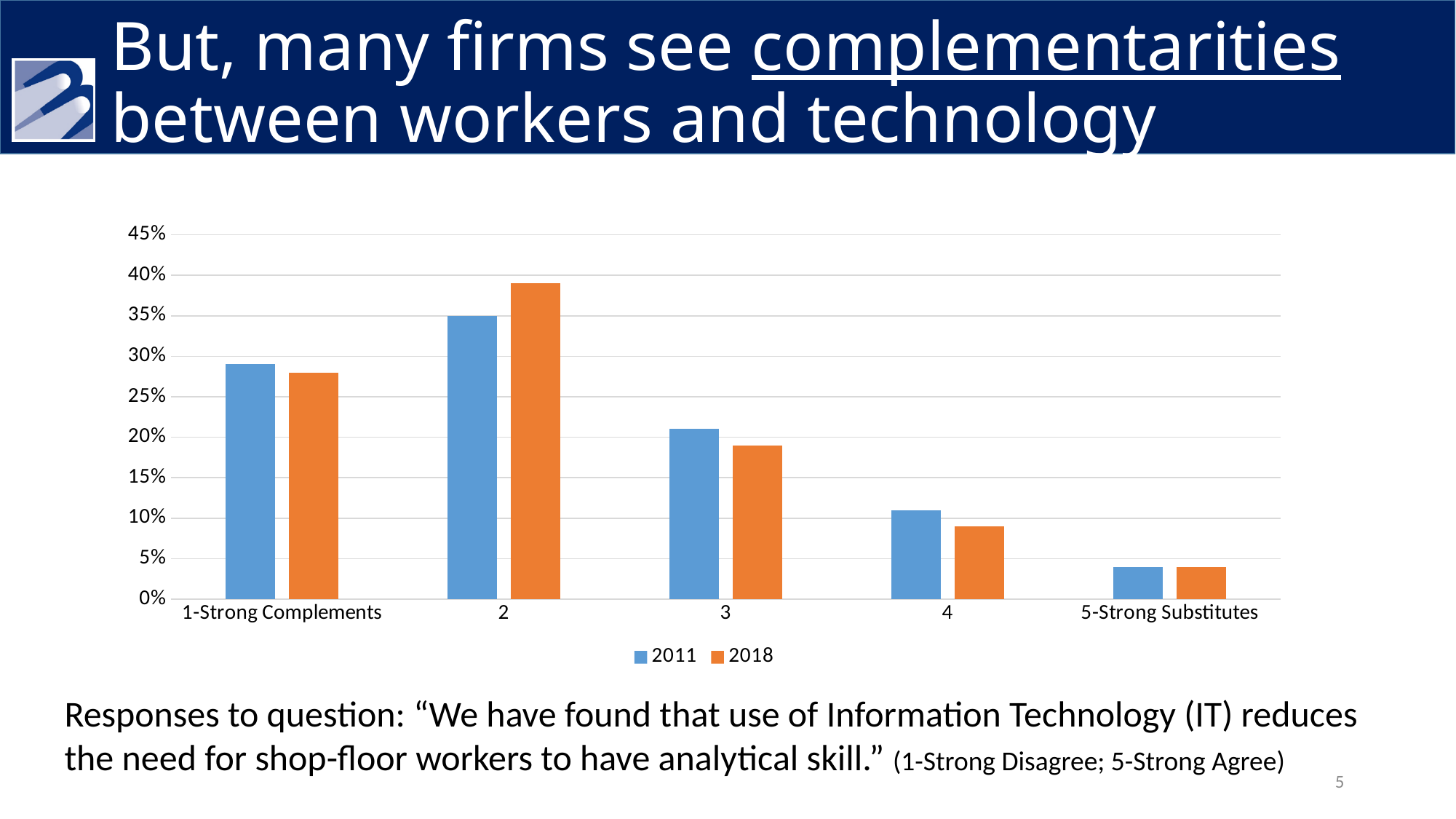
From category 2 to 5-Strong Substitutes, do the 2018 values rise or fall? fall For category 2, which series has the larger value, 2011 or 2018? 2018 Is the 2018 value for category 2 greater or less than 35%? greater What kind of chart is shown on the slide? bar chart Which category has the highest value for the 2011 series? 2 Which category has the highest value for the 2018 series? 2 How many categories are shown on the x axis? 5 For category 3, which series has the larger value, 2011 or 2018? 2011 Is the 2011 value for 1-Strong Complements greater or less than 25%? greater Which category has the lowest value for the 2018 series? 5-Strong Substitutes Is the 2011 value for category 4 greater or less than 15%? less How many series does the legend list? 2